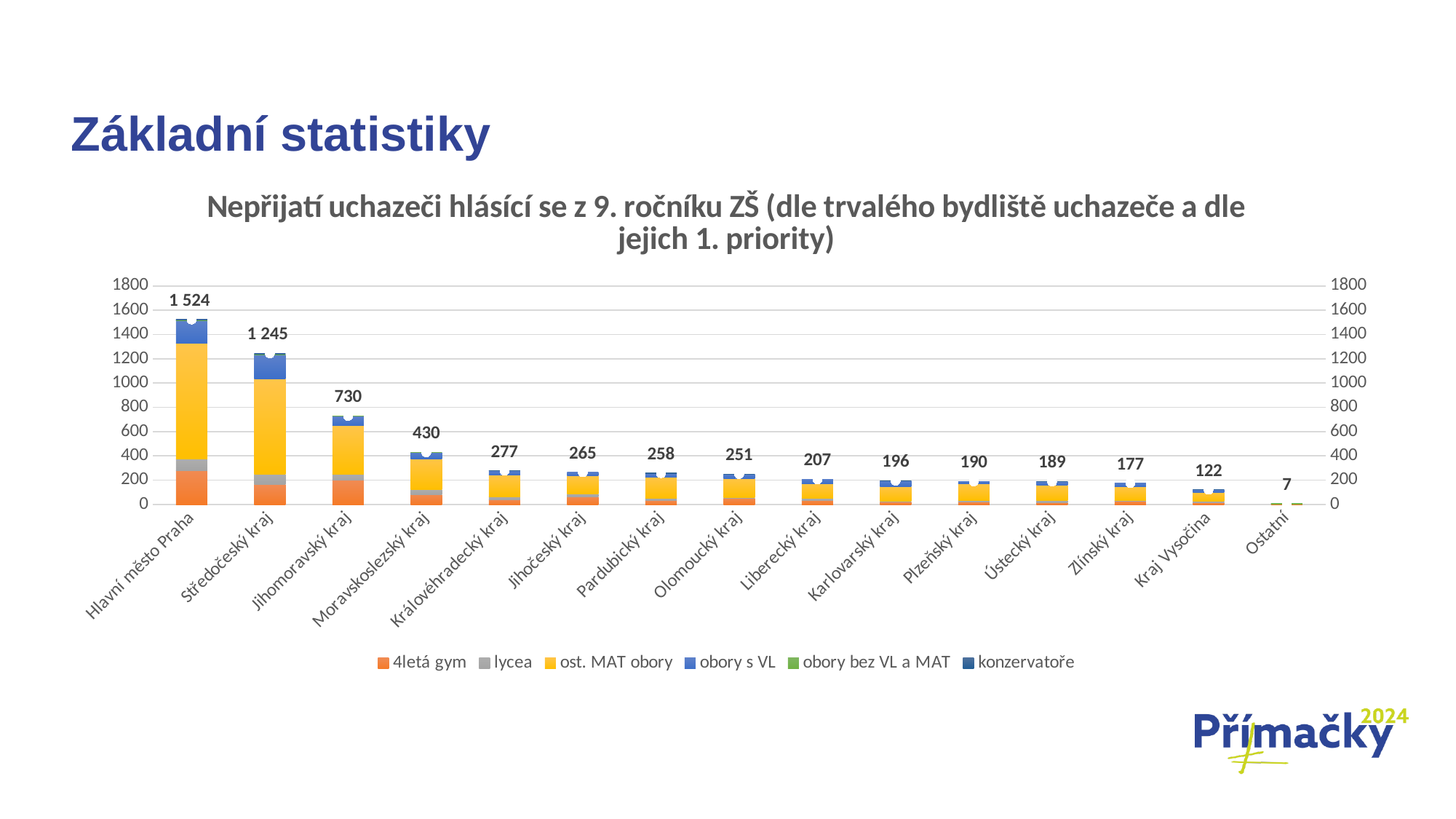
How many categories are shown on the x axis? 15 What is the difference between the totals for Hlavní město Praha and Středočeský kraj? 279 What kind of chart is shown on the slide? Stacked bar chart How many series does the legend list? 6 What is the total value shown for Hlavní město Praha? 1 524 Do the totals rise or fall from left to right along the x axis? fall Is the total for Jihomoravský kraj greater or less than 800? less Which category has the lowest total? Ostatní What is the total value shown for Středočeský kraj? 1 245 Which category has the highest total? Hlavní město Praha What is the total value shown for Kraj Vysočina? 122 Which has a larger total, Jihomoravský kraj or Moravskoslezský kraj? Jihomoravský kraj